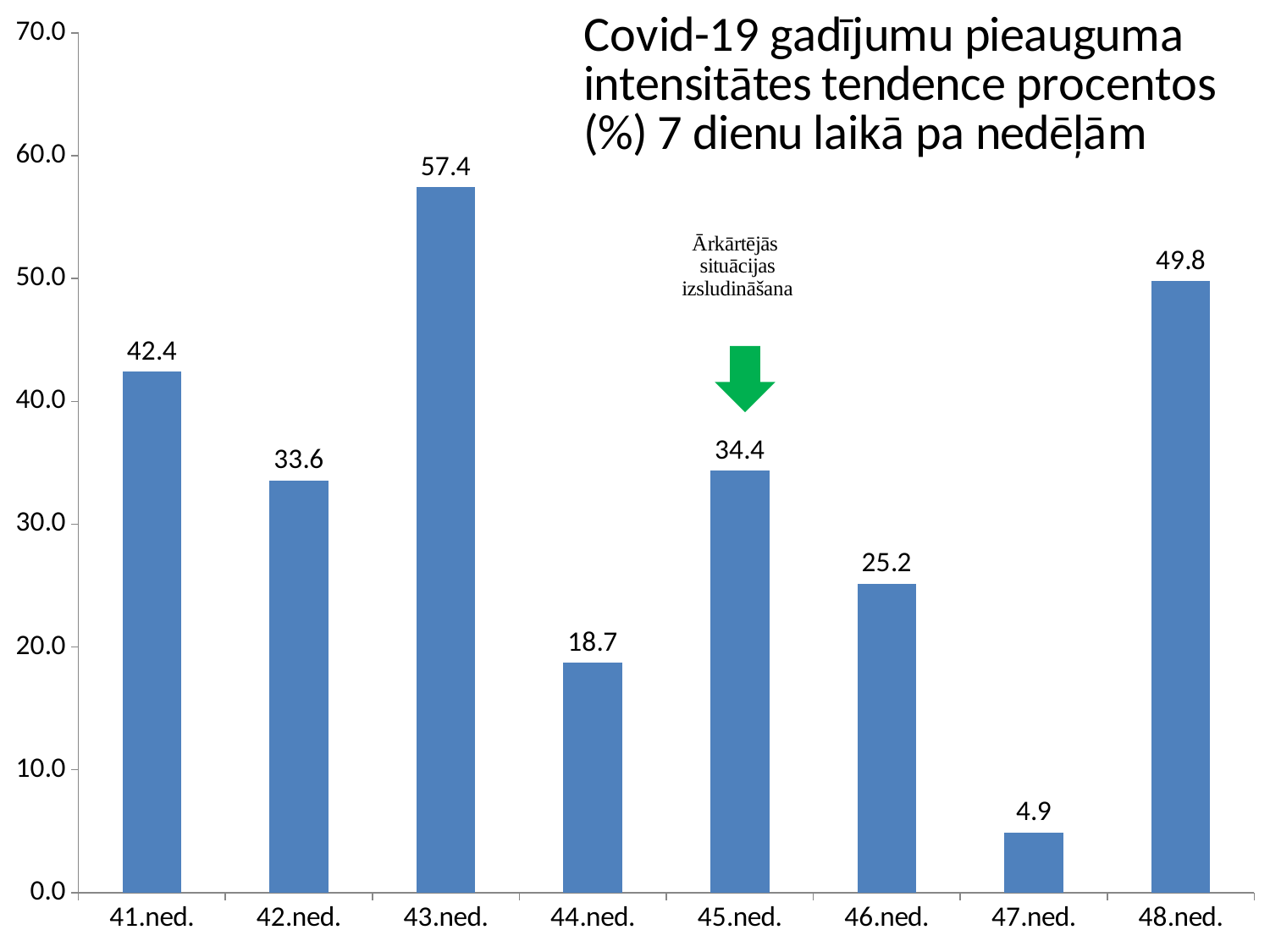
What is the value for 47.ned.? 4.9 What is the value for 43.ned.? 57.4 Do the values rise or fall from 45.ned. to 47.ned.? fall Which is larger, the value for 41.ned. or the value for 48.ned.? 48.ned. What text is written above the green arrow on the chart? Ārkārtējās situācijas izsludināšana What kind of chart is shown on the slide? bar chart Which week has the highest value? 43.ned. How many weeks are shown on the x axis? 8 Which week has the lowest value? 47.ned. Is the value for 46.ned. greater or less than 30.0? less What is the difference between the values for 43.ned. and 44.ned.? 38.7 What is the value for 45.ned.? 34.4